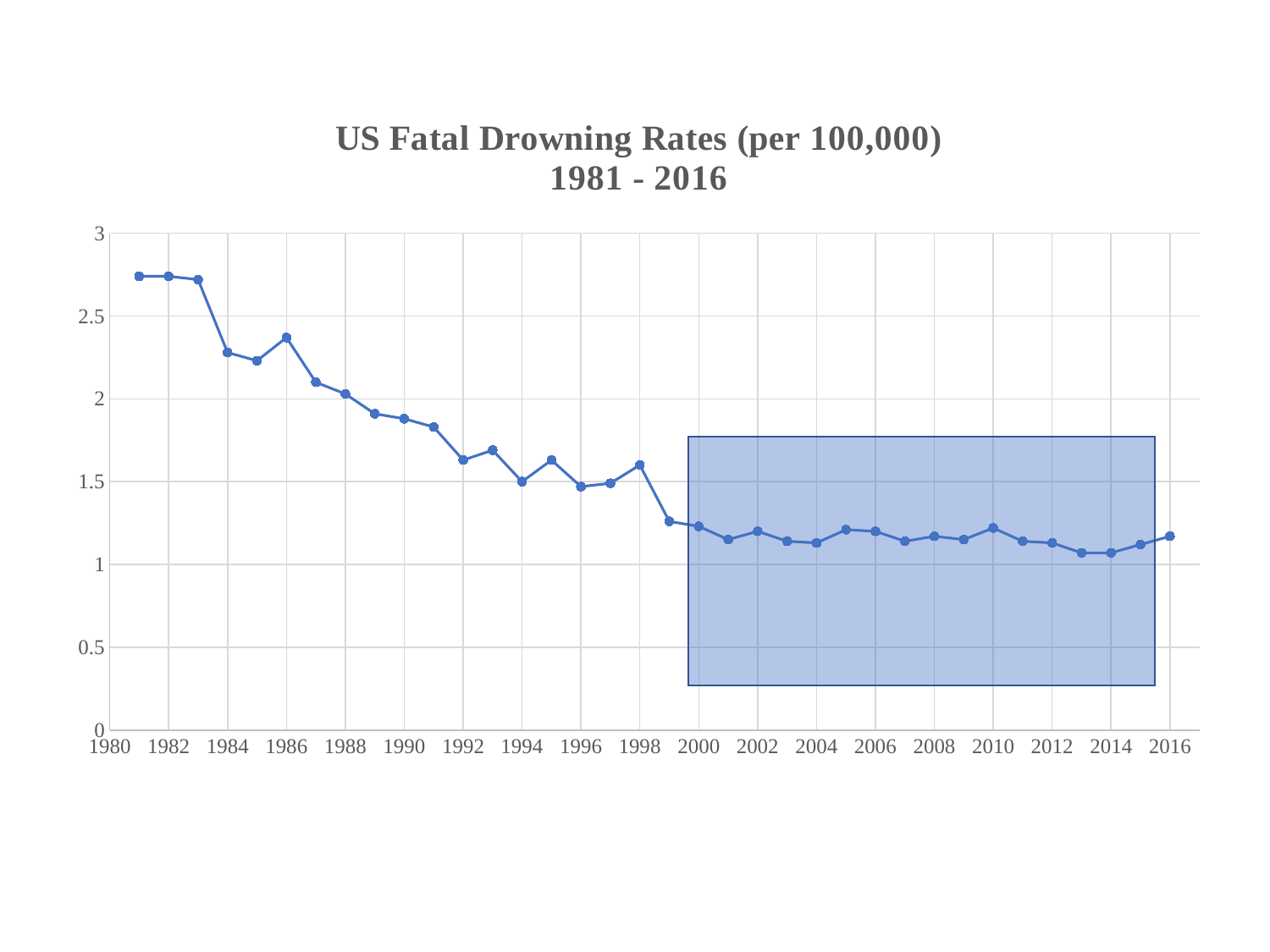
Is the value for 1990 greater or less than 2? less Is the value for 2016 greater or less than 1? greater Is the value for 1986 greater or less than 2? greater Which year has the larger value, 1981 or 2016? 1981 Which year has the larger value, 1998 or 1999? 1998 What kind of chart is shown on the slide? line chart Which year has the larger value, 1985 or 1986? 1986 What is the title of the chart? US Fatal Drowning Rates (per 100,000) 1981 - 2016 How many yearly data points are plotted on the chart? 36 Overall, do the drowning rates rise or fall from 1981 to 2016? fall